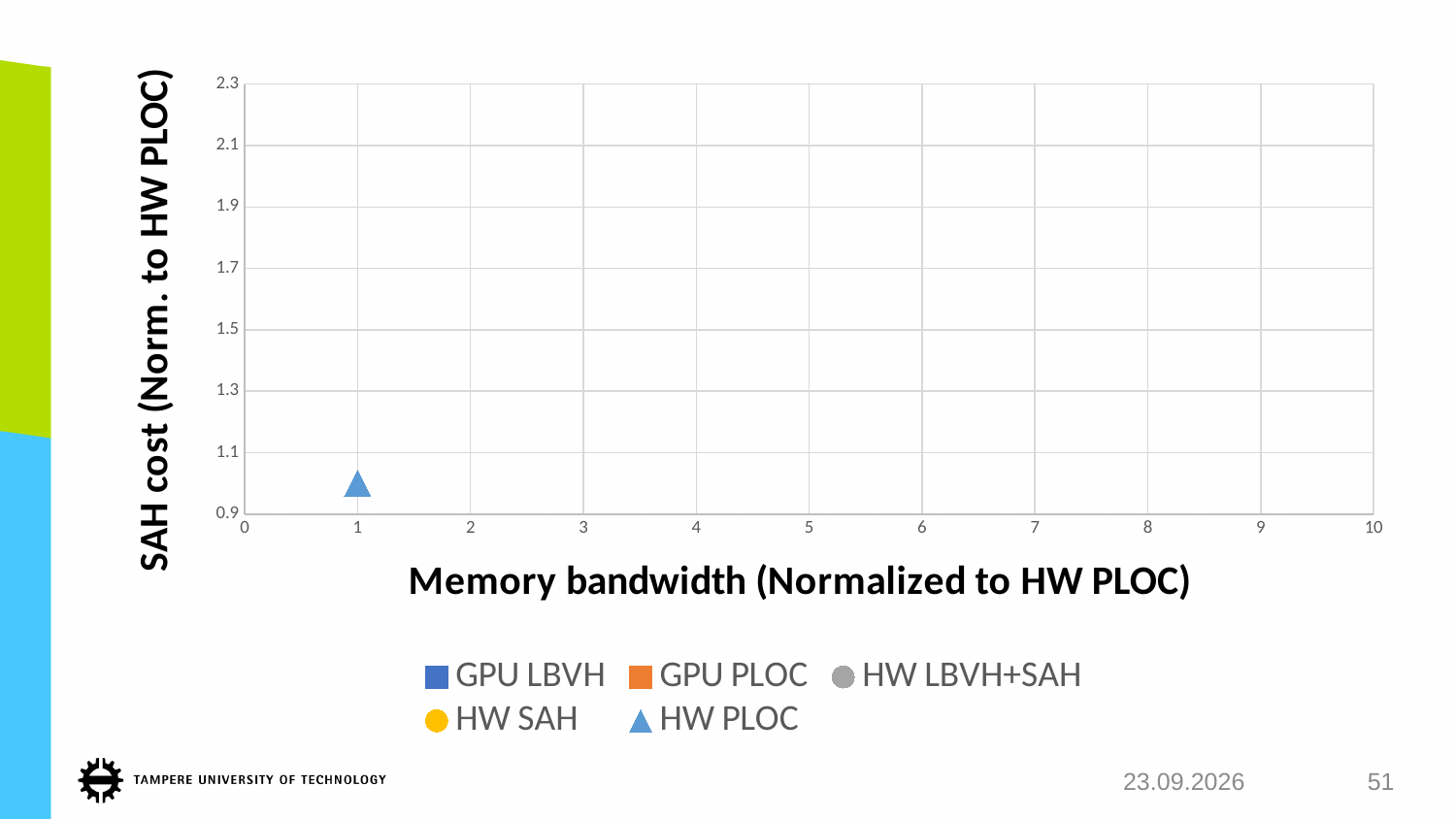
What is the title of the x axis? Memory bandwidth (Normalized to HW PLOC) What is the memory bandwidth value (x axis) of the HW PLOC point? 1 Is the SAH cost value for the HW PLOC point greater or less than 1.3? less How many data points are plotted on the chart? 1 What kind of chart is shown on the slide? scatter chart Is the SAH cost value for the HW PLOC point greater or less than 1.5? less Is the memory bandwidth value for the HW PLOC point greater or less than 5? less What is the maximum value shown on the x axis? 10 How many series does the legend list? 5 Which series is the only one with a visible point plotted on the chart? HW PLOC